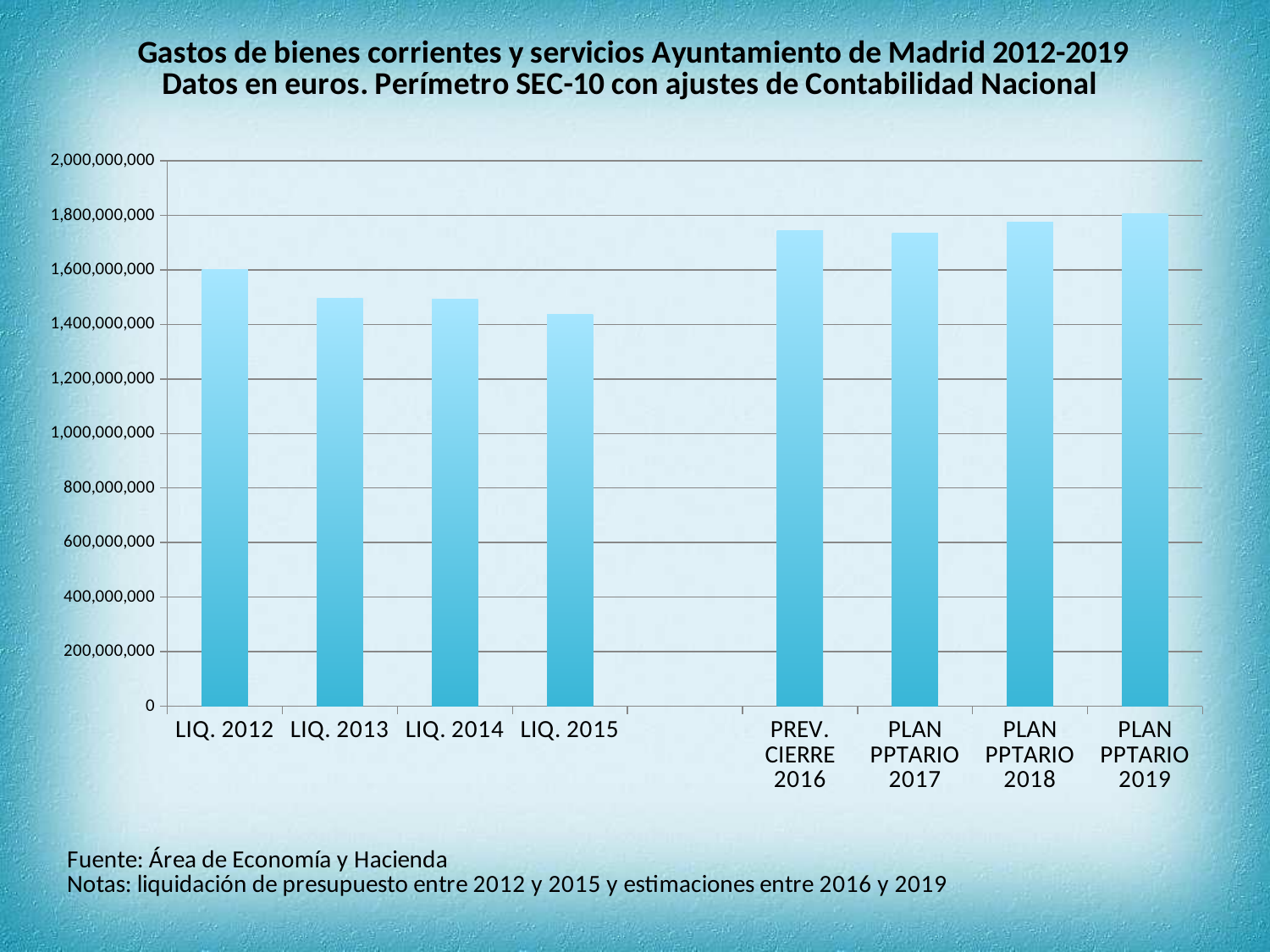
Is the value for LIQ. 2015 greater or less than 1,600,000,000? less Is the value for LIQ. 2013 greater or less than 1,600,000,000? less Is the value for PREV. CIERRE 2016 greater or less than 1,600,000,000? greater Which is larger, the value for PLAN PPTARIO 2019 or the value for LIQ. 2013? PLAN PPTARIO 2019 Which is larger, the value for LIQ. 2012 or the value for LIQ. 2015? LIQ. 2012 Do the values rise or fall from LIQ. 2012 to LIQ. 2015? fall Which category has the lowest value in the chart? LIQ. 2015 Which category has the highest value in the chart? PLAN PPTARIO 2019 According to the slide, what is the source of the data (Fuente)? Área de Economía y Hacienda How many bars (categories) are plotted in the chart? 8 What kind of chart is shown on the slide? bar chart